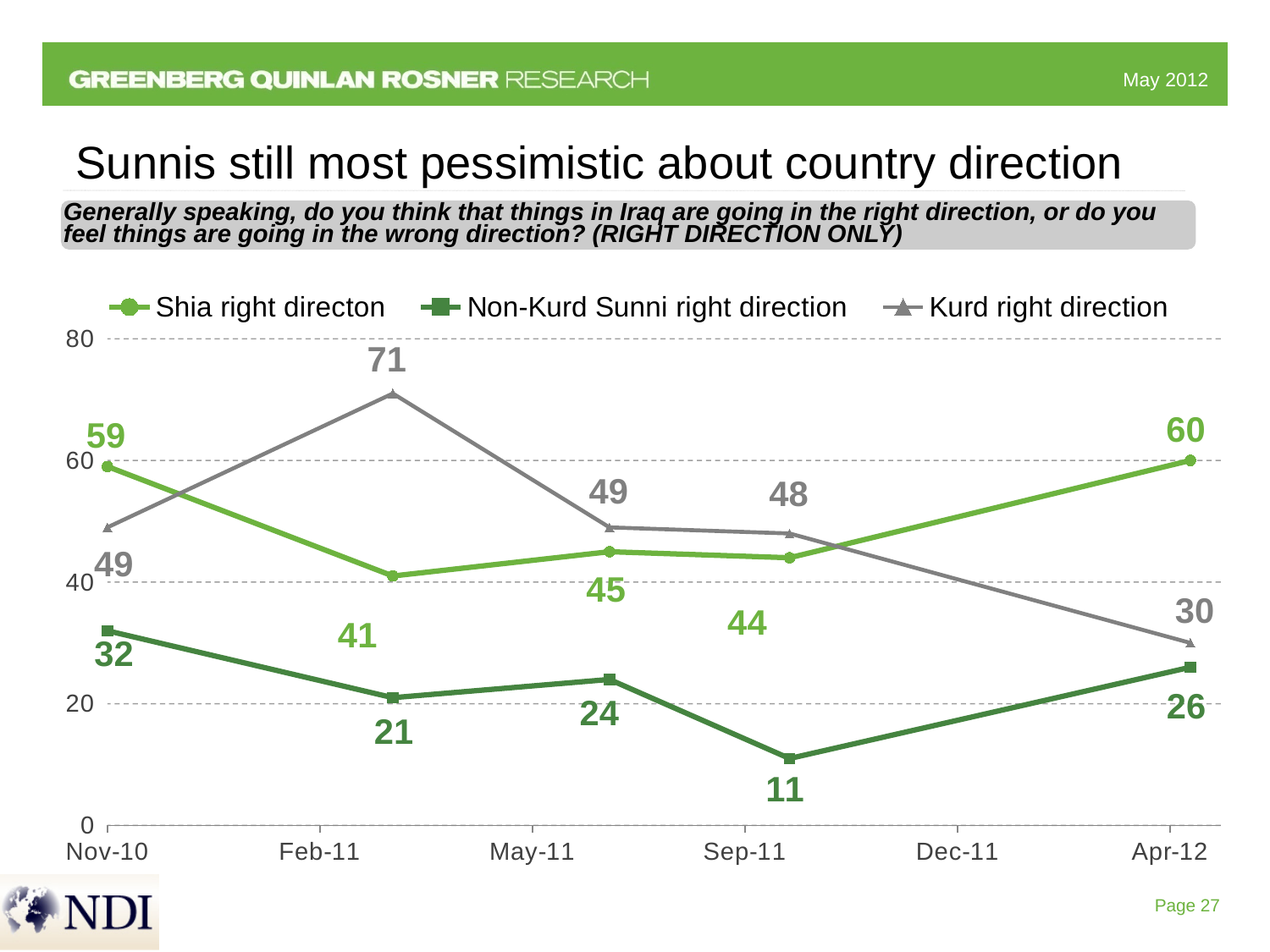
How many series does the legend list? 3 What is the lowest value reached by the Non-Kurd Sunni right direction line? 11 What is the value for Shia right direction at Nov-10? 59 What is the value for Non-Kurd Sunni right direction at Apr-12? 26 What is the difference between the Shia right direction value and the Non-Kurd Sunni right direction value at Apr-12? 34 Does the Kurd right direction line rise or fall between its peak of 71 and Apr-12? fall What is the highest value reached by the Kurd right direction line? 71 How many data points are plotted for each series? 5 What is the value for Kurd right direction at Apr-12? 30 What kind of chart is shown on the slide? line chart At Nov-10, which is larger: Shia right direction or Kurd right direction? Shia right direction What is the title of the slide? Sunnis still most pessimistic about country direction